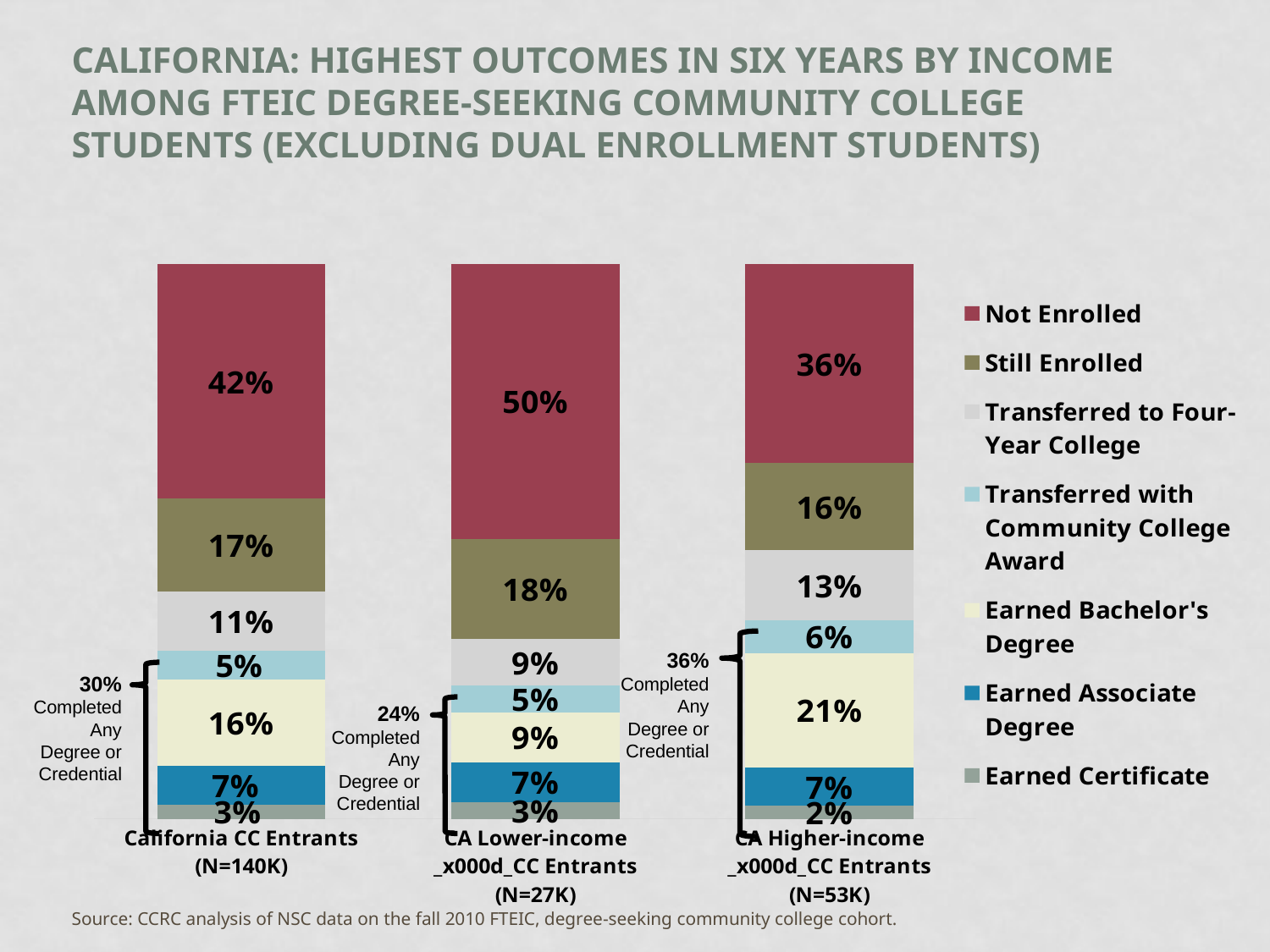
What kind of chart is shown on the slide? Stacked bar chart What is the difference in the Earned Bachelor's Degree percentage between CA Higher-income CC Entrants and CA Lower-income CC Entrants? 12% What percentage of CA Higher-income CC Entrants Earned a Bachelor's Degree? 21% Which group has the lowest Earned Certificate percentage? CA Higher-income CC Entrants How many groups (bars) are shown in the chart? 3 What percentage of CA Higher-income CC Entrants Transferred to a Four-Year College? 13% What percentage of California CC Entrants (N=140K) were Still Enrolled? 17% How many series does the legend list? 7 What percentage of CA Lower-income CC Entrants were Not Enrolled? 50% According to the annotation, what percentage of CA Lower-income CC Entrants completed any degree or credential? 24% Which is larger: the Still Enrolled percentage for CA Lower-income CC Entrants or for CA Higher-income CC Entrants? CA Lower-income CC Entrants Which group has the highest Not Enrolled percentage? CA Lower-income CC Entrants